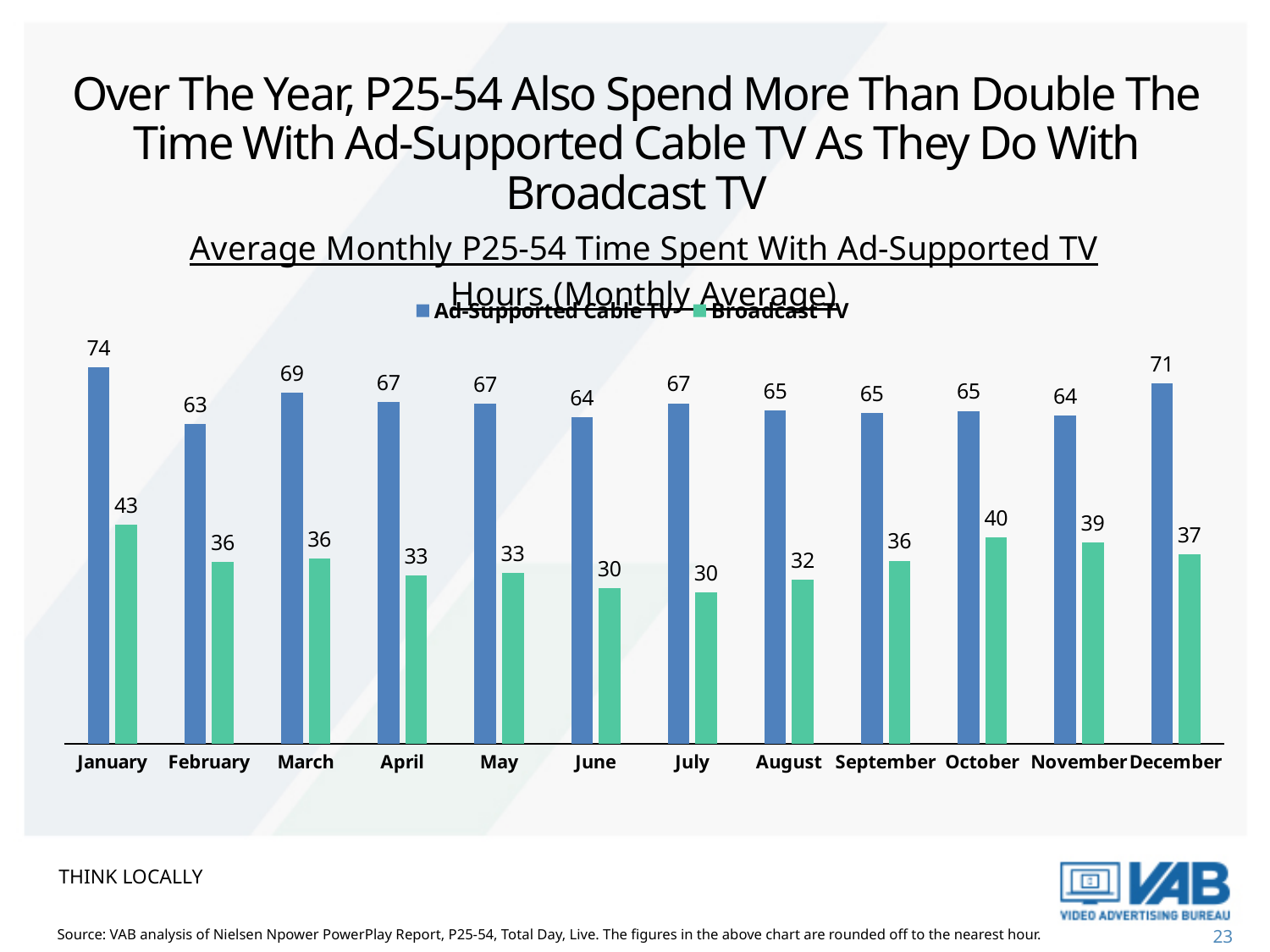
What is the Ad-Supported Cable TV value for January? 74 Which month has the highest Ad-Supported Cable TV value? January What is the difference between the Broadcast TV values for January and June? 13 What is the Broadcast TV value for August? 32 What kind of chart is shown on the slide? Bar chart How many months are shown on the x axis? 12 Which month has the lowest Broadcast TV value? June and July Which series is shown in green in the legend? Broadcast TV What is the Broadcast TV value for October? 40 How many series does the legend list? 2 What is the difference between the Ad-Supported Cable TV and Broadcast TV values in January? 31 Which is larger in December: the Ad-Supported Cable TV value or the Broadcast TV value? Ad-Supported Cable TV